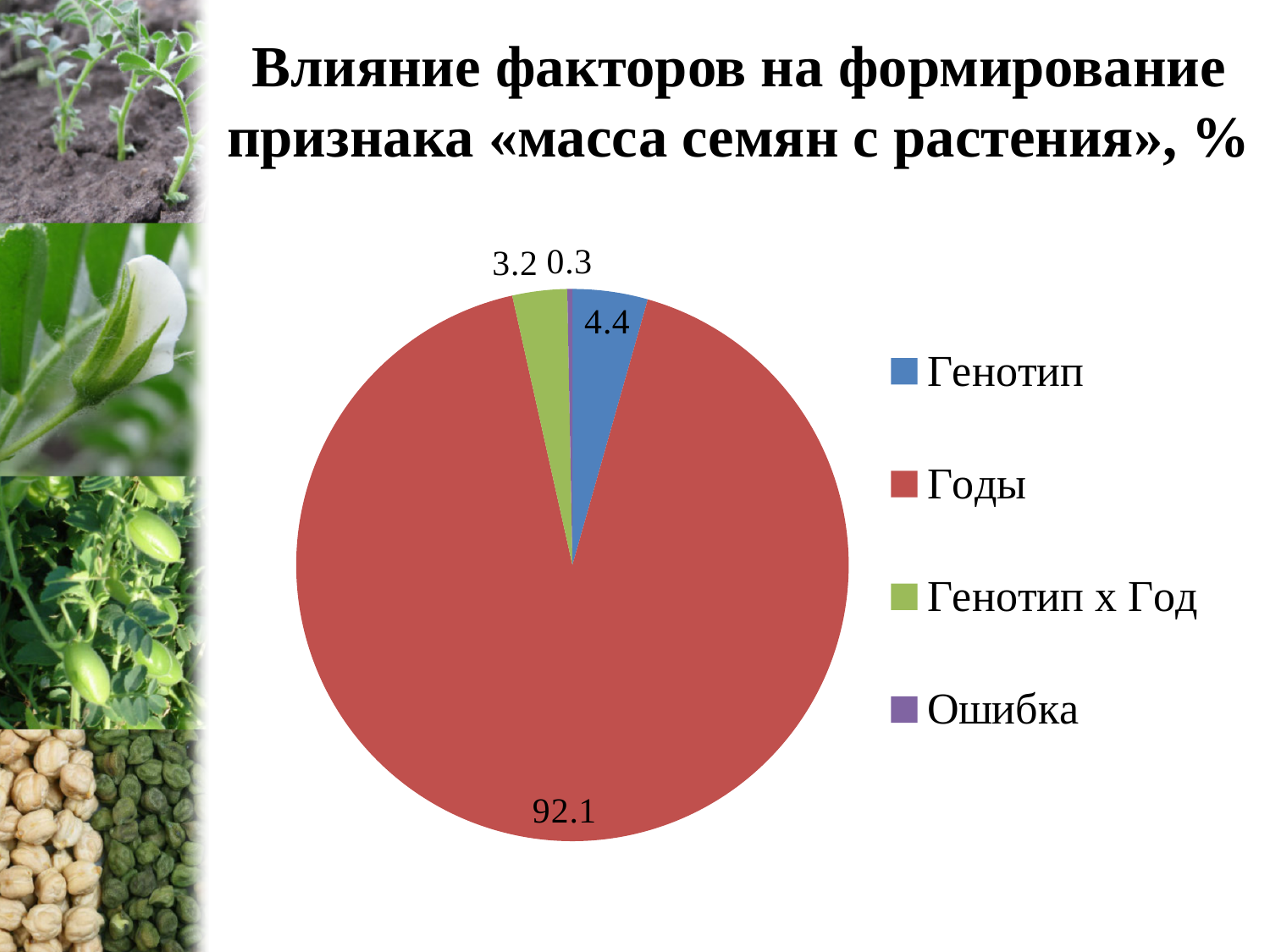
What is the value for Годы? 92.1 Which is larger, the value for Генотип or the value for Генотип x Год? Генотип What colour is the Годы slice in the pie chart? red Which category has the largest slice of the pie? Годы Which category has the smallest slice of the pie? Ошибка What is the value for Ошибка? 0.3 How many categories does the pie chart have? 4 What is the value for Генотип x Год? 3.2 What type of chart is shown on the slide? pie chart What share of the pie does the Годы slice represent, in percent? 92.1 What is the value for Генотип? 4.4 What is the difference between the values for Генотип and Генотип x Год? 1.2